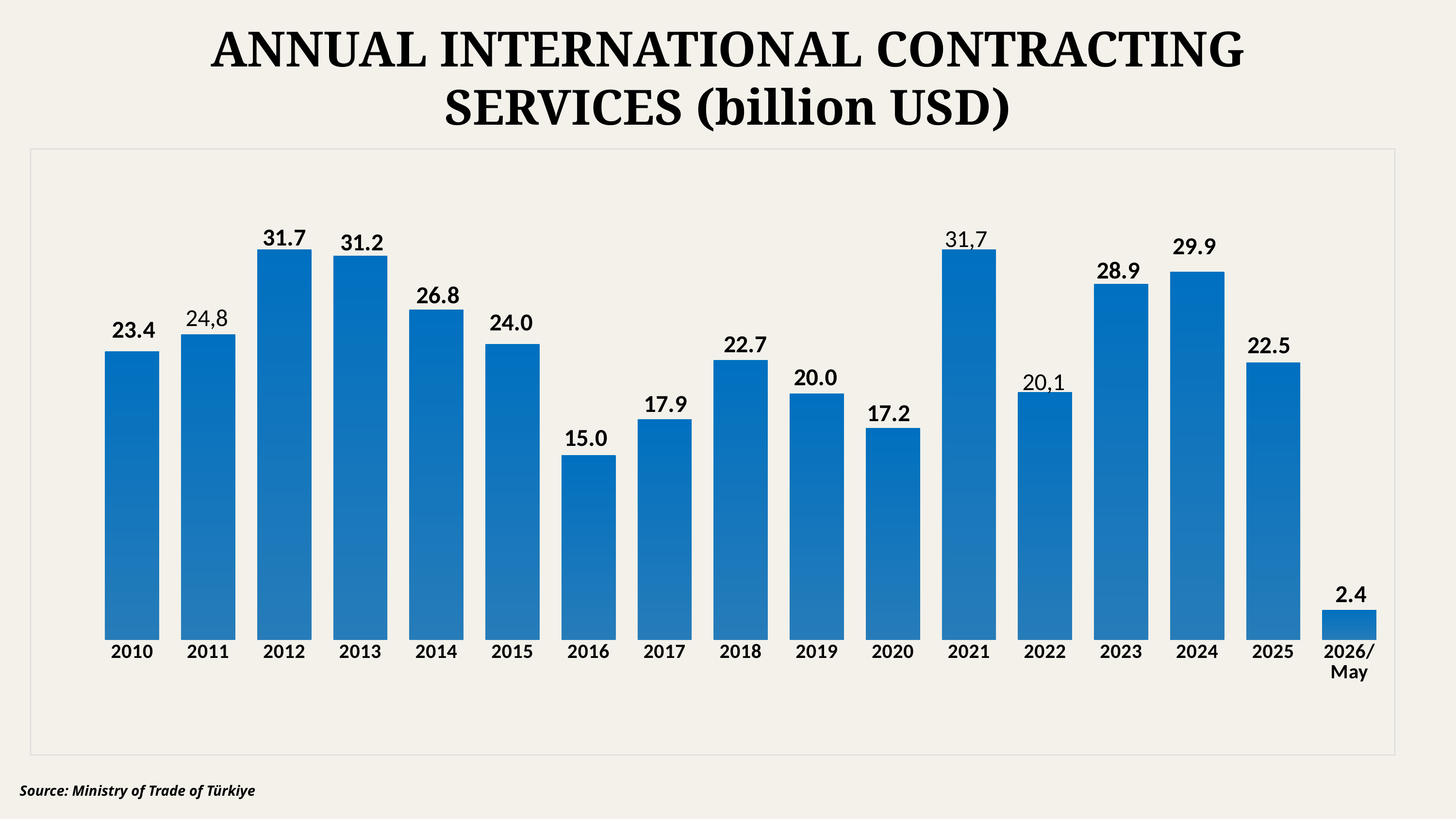
What kind of chart is shown on the slide? Bar chart What is the value for 2022? 20,1 What is the difference between the values for 2013 and 2016? 16.2 What is the value for 2016? 15.0 What is the value for 2026/May? 2.4 Do the values rise or fall from 2013 to 2016? Fall What is the value for 2012? 31.7 Which category has the lowest value? 2026/May What is the difference between the values for 2024 and 2025? 7.4 What is the value for 2024? 29.9 Which is larger, the value for 2014 or the value for 2015? 2014 How many bars are shown in the chart? 17